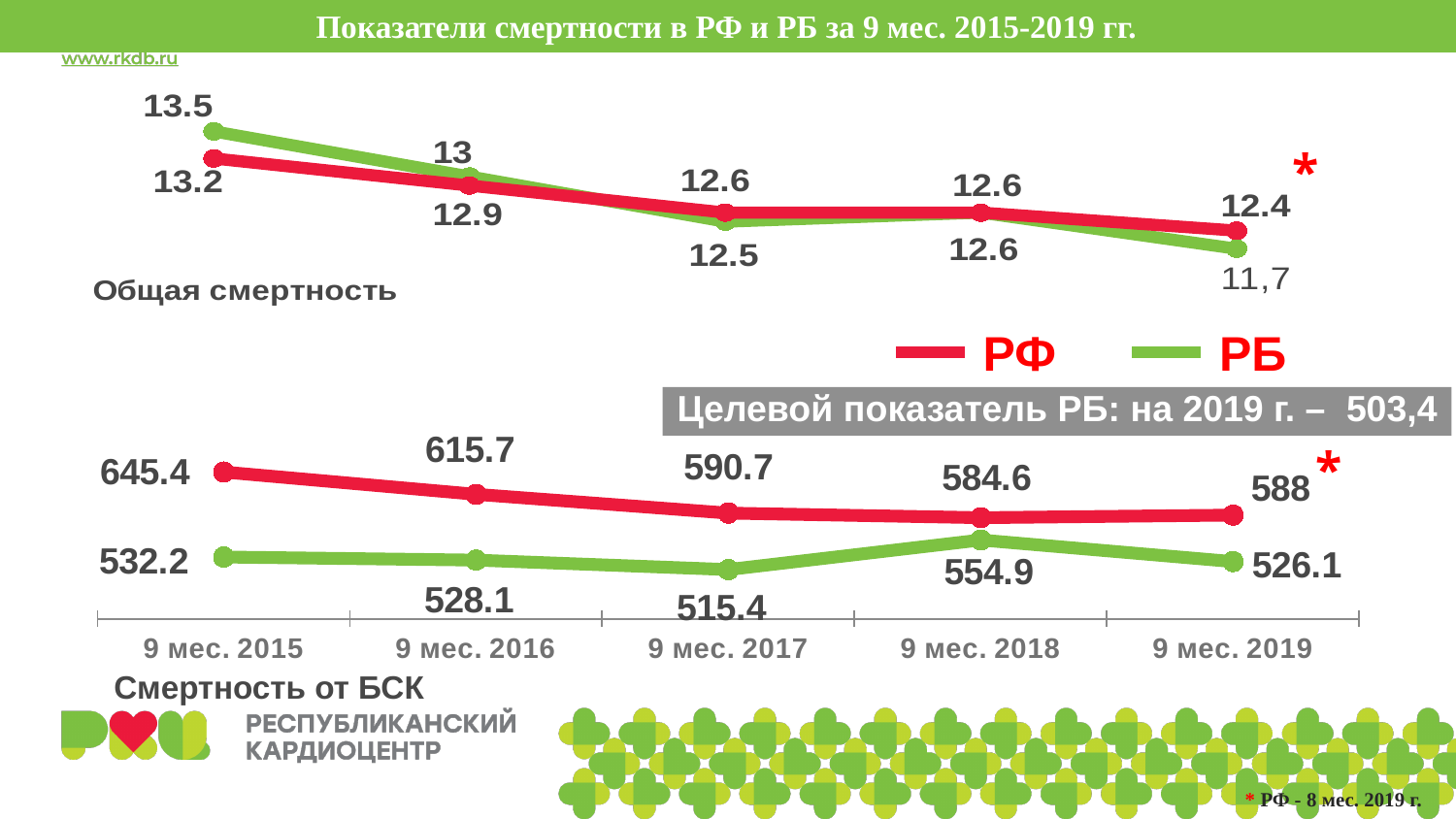
In the 'Общая смертность' chart, what is the value for РБ in 9 мес. 2015? 13.5 In the 'Смертность от БСК' chart, what is the value for РБ in 9 мес. 2018? 554.9 In the 'Смертность от БСК' chart, in which period is the РФ value highest? 9 мес. 2015 What type of chart is the 'Смертность от БСК' chart? Line chart In the 'Смертность от БСК' chart, in which period is the РБ value lowest? 9 мес. 2017 In the 'Общая смертность' chart, what is the value for РФ in 9 мес. 2019? 12.4 How many series does the legend list? 2 How many periods are shown on the x axis of the 'Смертность от БСК' chart? 5 In the 'Смертность от БСК' chart, what is the difference between РФ and РБ in 9 мес. 2015? 113.2 In the 'Смертность от БСК' chart, what is the value for РФ in 9 мес. 2015? 645.4 In the 'Общая смертность' chart, which series has the larger value in 9 мес. 2019, РФ or РБ? РФ In the 'Смертность от БСК' chart, does the РФ value rise or fall from 9 мес. 2015 to 9 мес. 2018? Fall